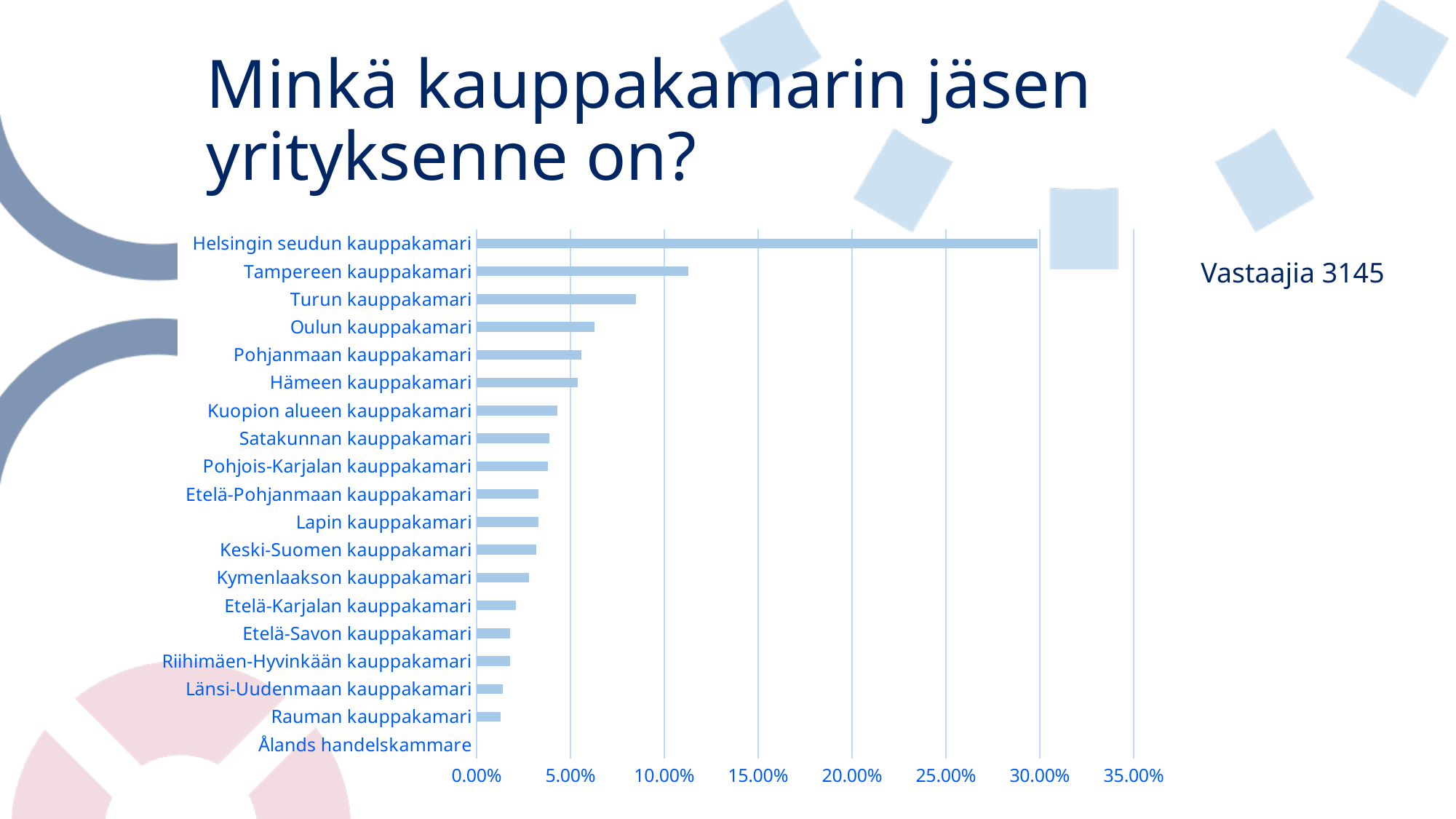
Is the value for Kuopion alueen kauppakamari greater or less than 5.00%? less Is the value for Tampereen kauppakamari greater or less than 10.00%? greater Which category has the lowest value in the chart? Ålands handelskammare How many categories are listed on the chart's vertical axis? 19 Is the value for Turun kauppakamari greater or less than 10.00%? less What kind of chart is shown on the slide? bar chart Which chamber of commerce has the highest share of respondents? Helsingin seudun kauppakamari Which has a larger value, Tampereen kauppakamari or Turun kauppakamari? Tampereen kauppakamari What is the highest tick label shown on the horizontal axis? 35.00% Do the bar values increase or decrease going from the top category to the bottom category? decrease